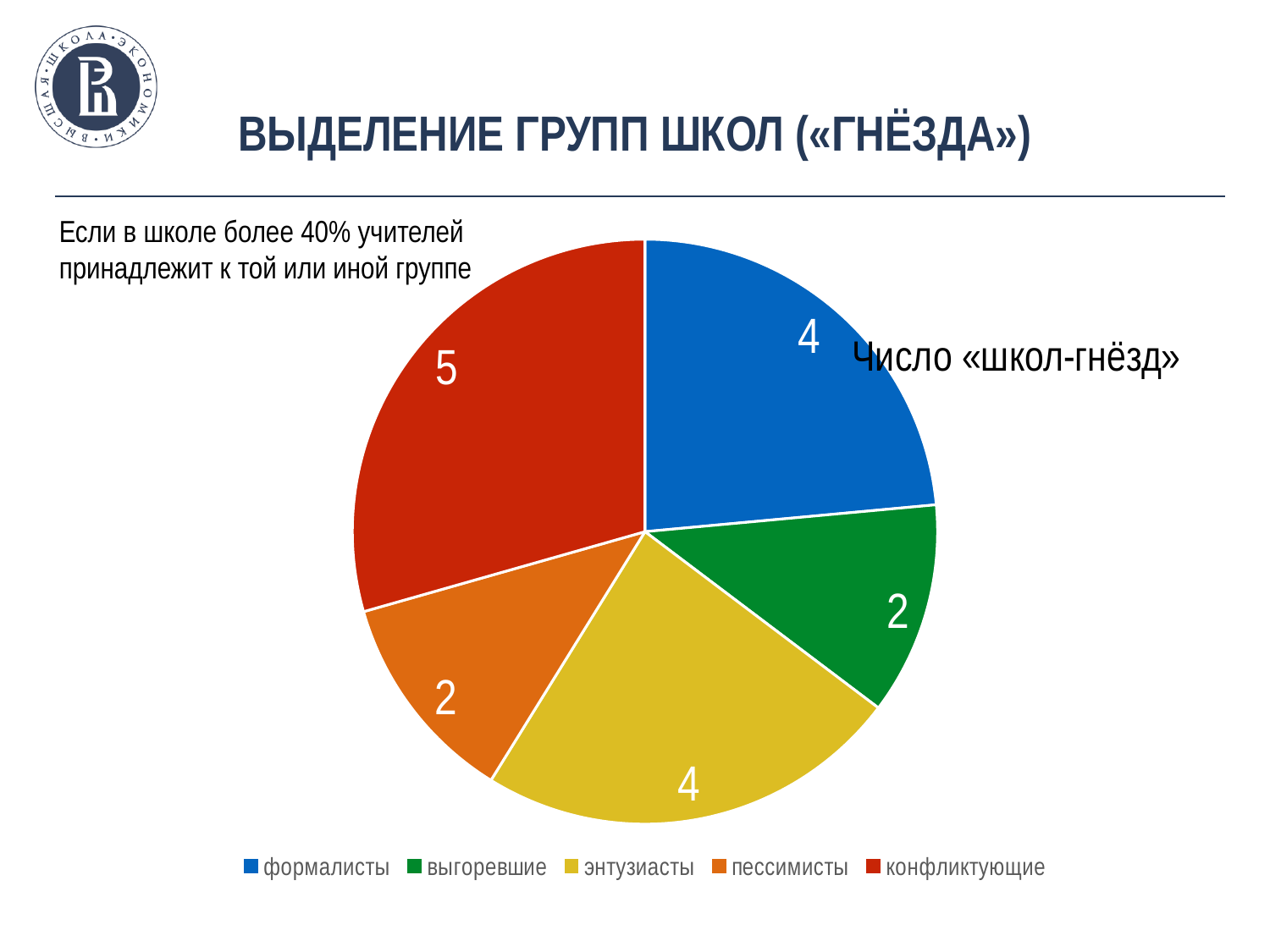
What is the value for конфликтующие in the pie chart? 5 What type of chart is shown on the slide? pie chart What is the total of all the values shown in the pie chart? 17 Which is larger, the value for формалисты or the value for пессимисты? формалисты What is the value for энтузиасты in the pie chart? 4 What is the value for формалисты in the pie chart? 4 How many categories does the pie chart have? 5 What is the value for выгоревшие in the pie chart? 2 Which category has the largest slice in the pie chart? конфликтующие What is the difference between the values for конфликтующие and выгоревшие? 3 What is the title of the pie chart? Число «школ-гнёзд» What is the value for пессимисты in the pie chart? 2